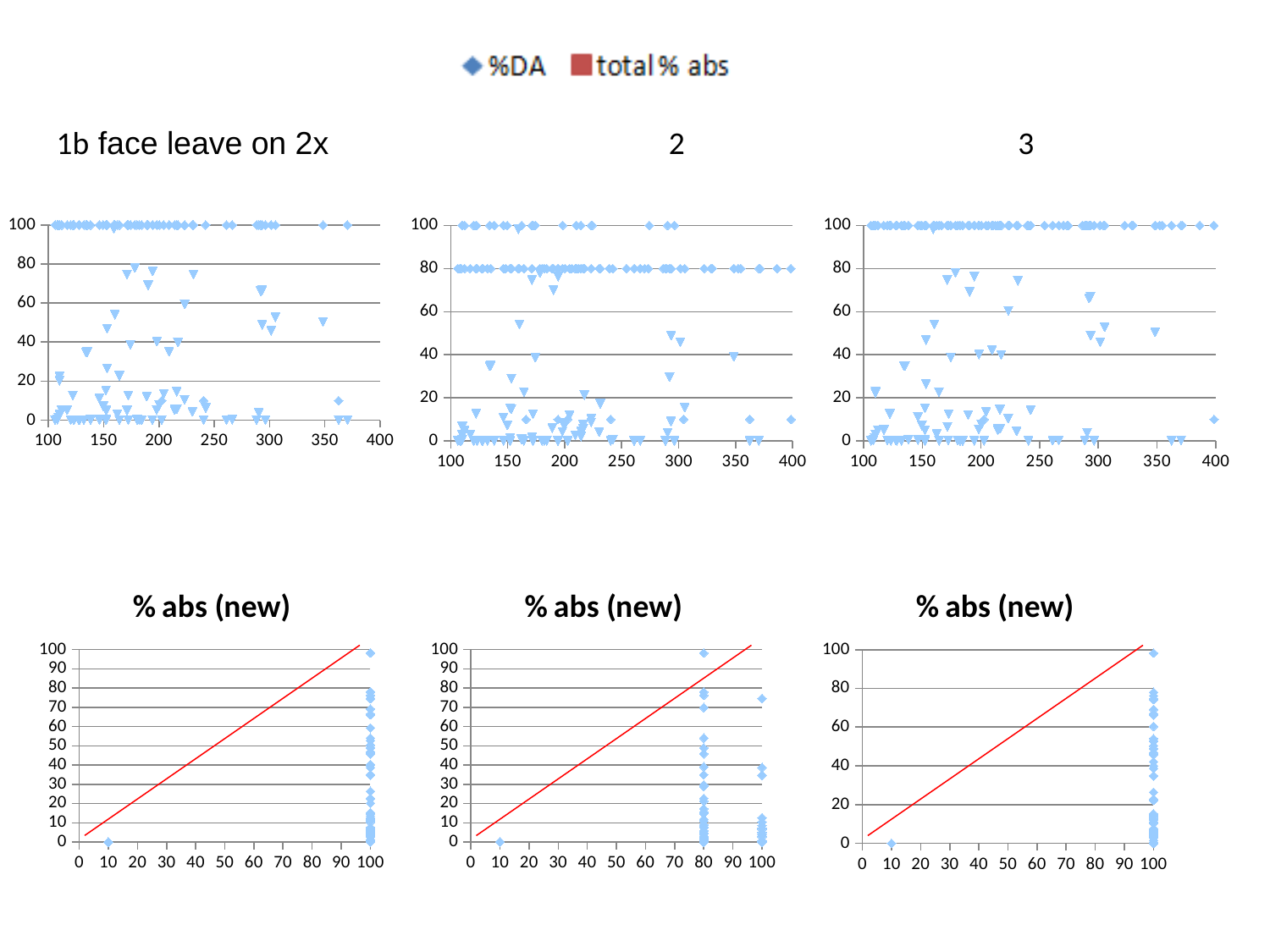
What is the title of the bottom-right chart? % abs (new) In the bottom-right "% abs (new)" chart, does the red line rise or fall from left to right along the x axis? rise How many series does the legend at the top of the slide list? 2 In the top-middle chart labeled "2", at what y value does the dense horizontal band of points just below the top band lie? 80 What kind of chart is the top-left chart labeled "1b face leave on 2x"? scatter chart How many charts are on the slide? 6 How many charts are in the bottom row of the slide? 3 What kind of chart is the bottom-middle "% abs (new)" chart? scatter chart What are the two entries in the legend at the top of the slide? %DA and total % abs In the bottom-middle "% abs (new)" chart, at which two x values do the points cluster? 80 and 100 In the bottom-left "% abs (new)" chart, at what x value do nearly all the points cluster? 100 In the bottom-left "% abs (new)" chart, is the y value of the single point near x=10 greater or less than 20? less